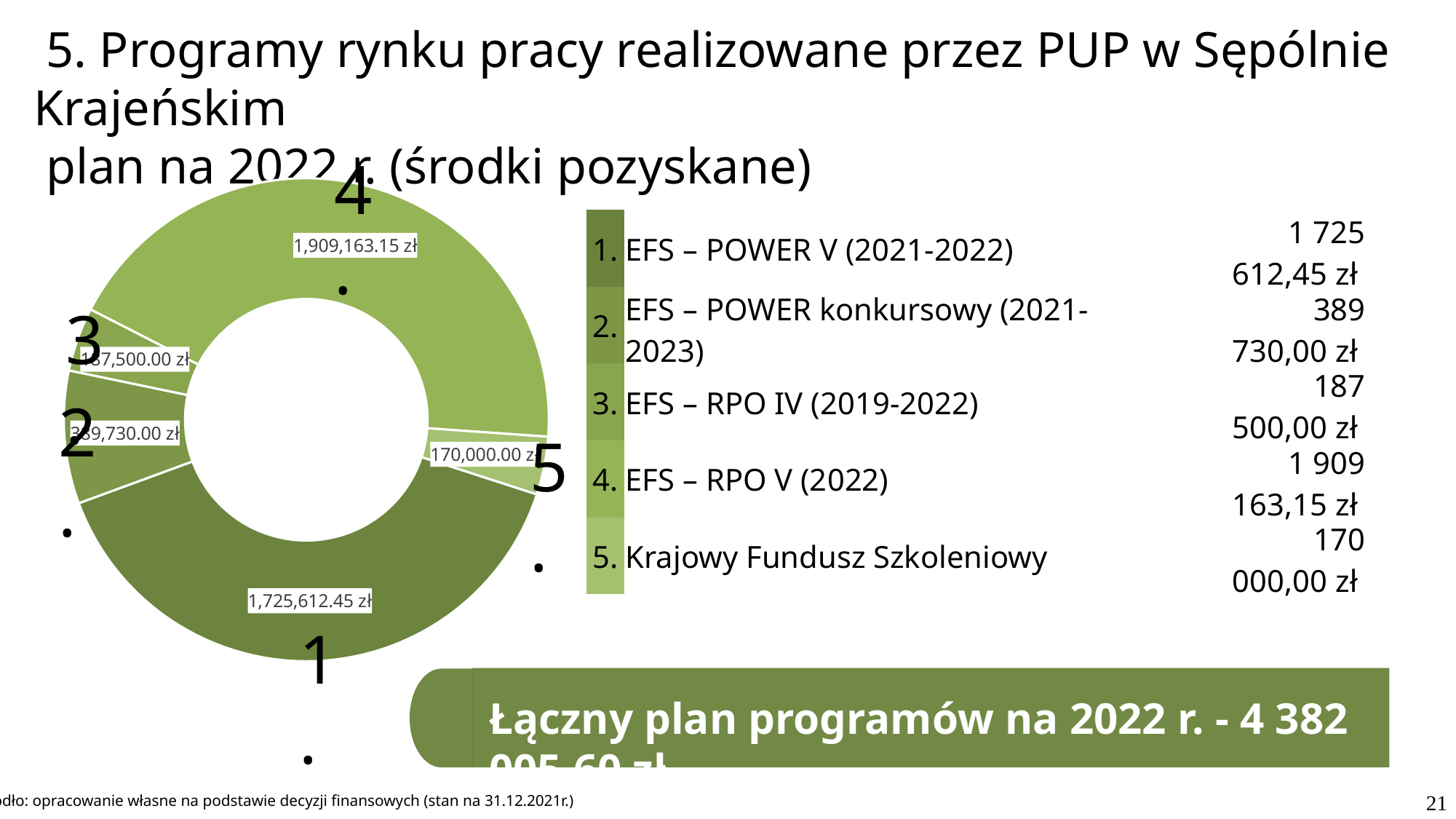
Which program has the smallest slice in the chart? 5. Krajowy Fundusz Szkoleniowy What value is shown for slice 4 (EFS – RPO V (2022)) in the chart? 1,909,163.15 zł What value is shown for slice 1 (EFS – POWER V (2021-2022)) in the chart? 1,725,612.45 zł How many slices does the chart have? 5 What is the difference between the values for slice 2 and slice 3? 202,230.00 zł What is the difference between the values for slice 4 and slice 1? 183,550.70 zł What value is shown for slice 5 (Krajowy Fundusz Szkoleniowy) in the chart? 170,000.00 zł What is the total of all five slices in the chart? 4,382,005.60 zł What kind of chart is shown on the slide? Pie (doughnut) chart Which program has the largest slice in the chart? 4. EFS – RPO V (2022) Which is larger: the value for slice 2 (EFS – POWER konkursowy) or slice 3 (EFS – RPO IV)? Slice 2 (EFS – POWER konkursowy) What value is shown for slice 3 (EFS – RPO IV (2019-2022)) in the chart? 187,500.00 zł